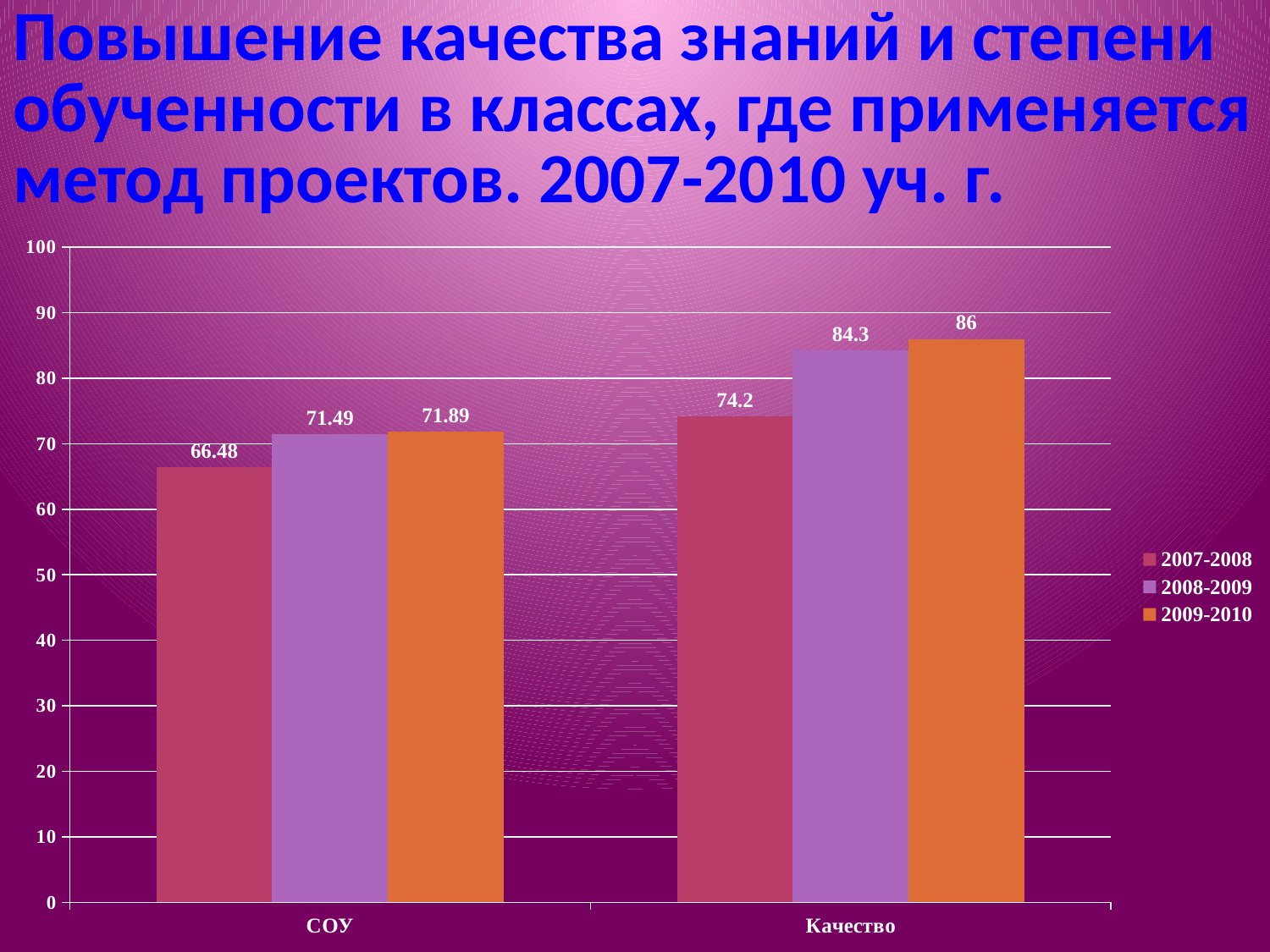
Which series has the lowest value for СОУ? 2007-2008 What is the value for СОУ in 2007-2008? 66.48 What is the value for Качество in 2009-2010? 86 Which is larger: the СОУ value for 2008-2009 or the СОУ value for 2007-2008? 2008-2009 How many series does the legend list? 3 What kind of chart is shown on the slide? bar chart What is the value for Качество in 2008-2009? 84.3 What is the difference between the Качество values for 2009-2010 and 2007-2008? 11.8 Which series has the highest value for Качество? 2009-2010 What is the value for СОУ in 2009-2010? 71.89 Is the value for Качество in 2007-2008 greater or less than 70? greater How many categories are shown on the x axis? 2